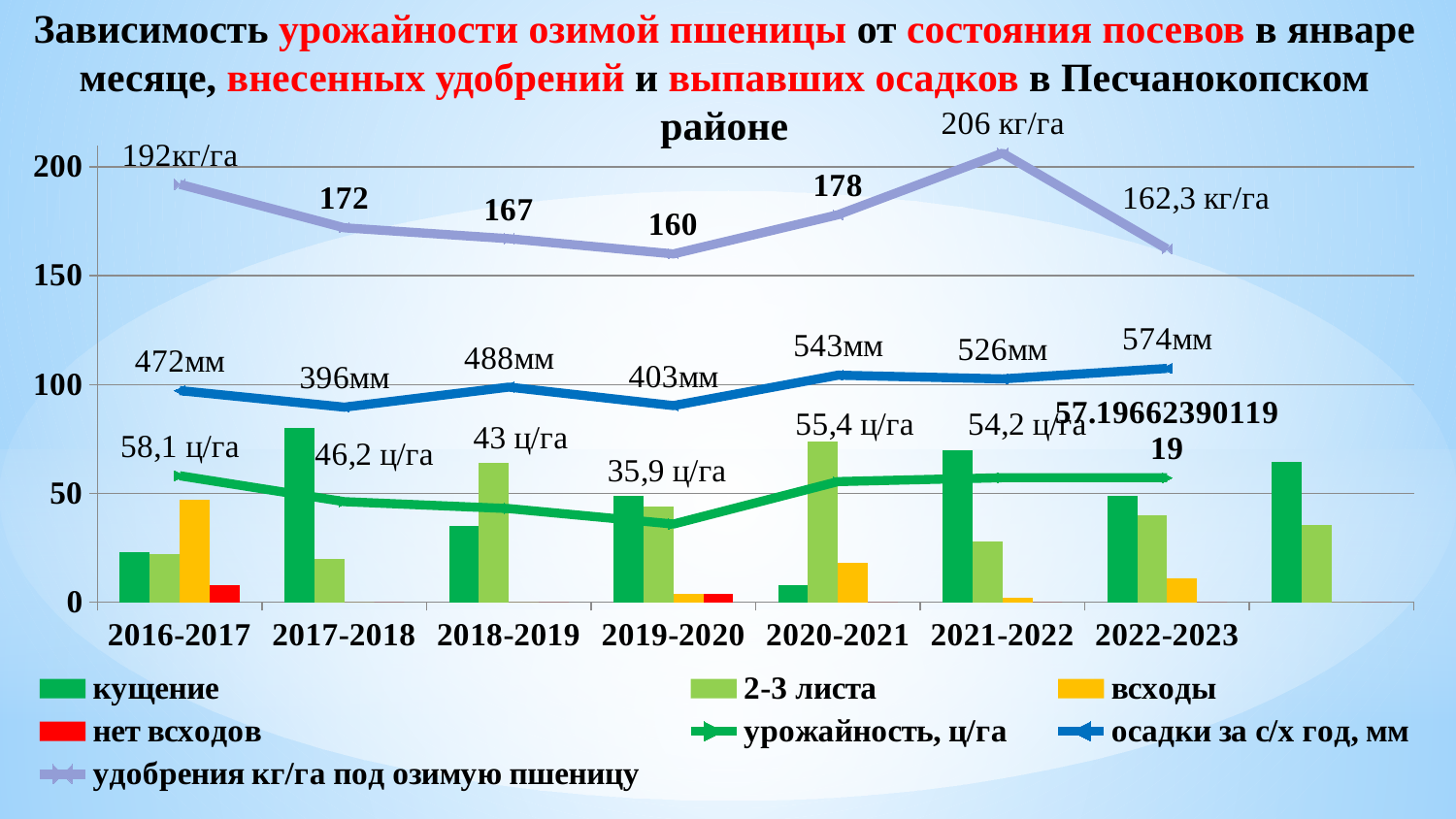
How many series does the legend list? 7 What is the yield (урожайность, ц/га) value for 2019-2020? 35,9 ц/га Is the value of the 2-3 листа bar for 2021-2022 greater or less than 50? less In which season is the precipitation series (осадки за с/х год, мм) lowest? 2017-2018 What is the difference between the precipitation values for 2022-2023 (574мм) and 2017-2018 (396мм)? 178мм Is the value of the кущение bar for 2017-2018 greater or less than 50? greater What is the value of the fertilizer series (удобрения кг/га под озимую пшеницу) for 2016-2017? 192кг/га Does the fertilizer series (удобрения кг/га) rise or fall from 2016-2017 to 2019-2020? fall Which is larger: the yield for 2016-2017 or the yield for 2020-2021? 2016-2017 (58,1 ц/га) What is the precipitation (осадки за с/х год, мм) value for 2020-2021? 543мм In which season is the fertilizer series (удобрения кг/га) highest? 2021-2022 What kind of chart is shown on the slide? Combined bar and line chart